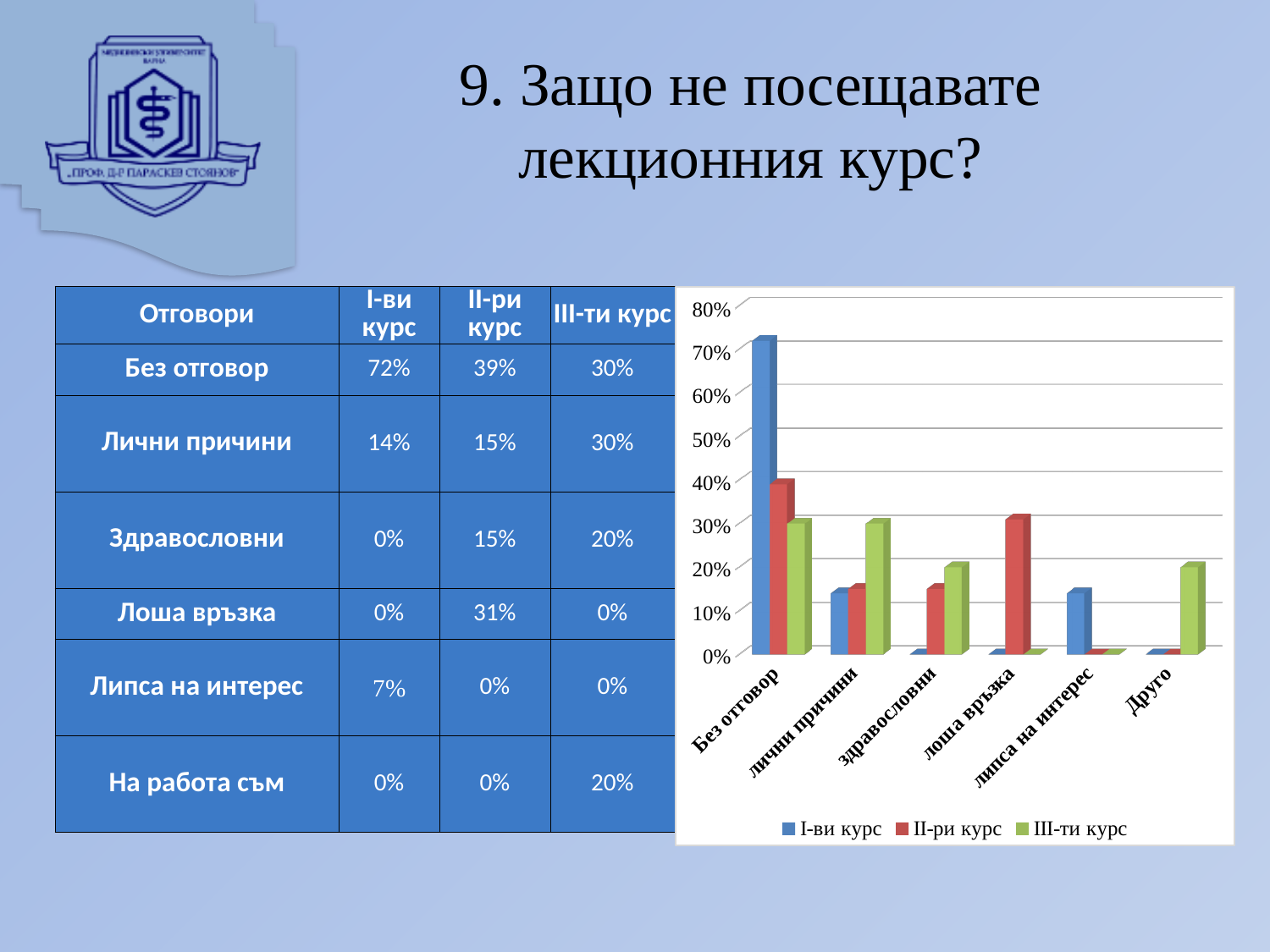
Which series is shown in blue in the chart's legend? I-ви курс Is the value for III-ти курс in the category Друго greater or less than 10%? greater How many categories are shown along the x axis of the chart? 6 Is the value for II-ри курс in the category Лоша връзка greater or less than 20%? greater What kind of chart is shown on the slide? bar chart How many series does the chart's legend list? 3 What is the value for I-ви курс in the category Без отговор? 72% In the category Лоша връзка, which is larger: II-ри курс or III-ти курс? II-ри курс What is the value for III-ти курс in the category Здравословни? 20% Which category has the highest value for I-ви курс? Без отговор What is the difference between I-ви курс and II-ри курс in the category Без отговор? 33 percentage points What are the three entries in the chart's legend? I-ви курс, II-ри курс, III-ти курс